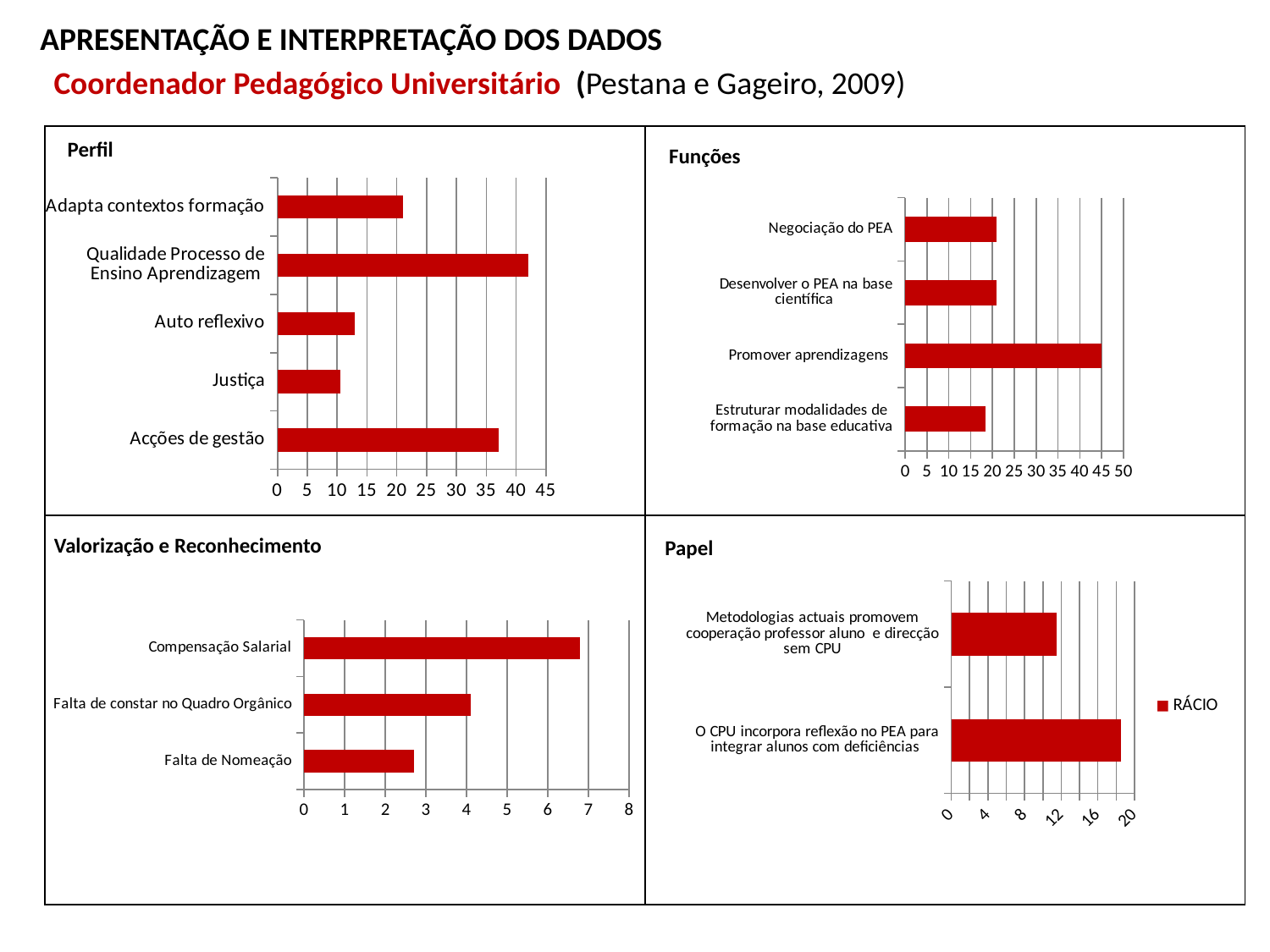
In the Valorização e Reconhecimento chart, which category has the lowest value? Falta de Nomeação What type of chart is the Valorização e Reconhecimento chart? Bar chart In the Papel chart, what series name does the legend show? RÁCIO In the Papel chart, which is larger: the value for 'O CPU incorpora reflexão no PEA para integrar alunos com deficiências' or the value for 'Metodologias actuais promovem cooperação professor aluno e direcção sem CPU'? O CPU incorpora reflexão no PEA para integrar alunos com deficiências In the Perfil chart, how many categories are plotted? 5 In the Perfil chart, which category has the highest value? Qualidade Processo de Ensino Aprendizagem In the Funções chart, is the value for Promover aprendizagens greater or less than 40? greater In the Perfil chart, is the value for Justiça greater or less than 15? less In the Valorização e Reconhecimento chart, is the value for Compensação Salarial greater or less than 6? greater In the Funções chart, how many categories are plotted? 4 In the Funções chart, which category has the highest value? Promover aprendizagens